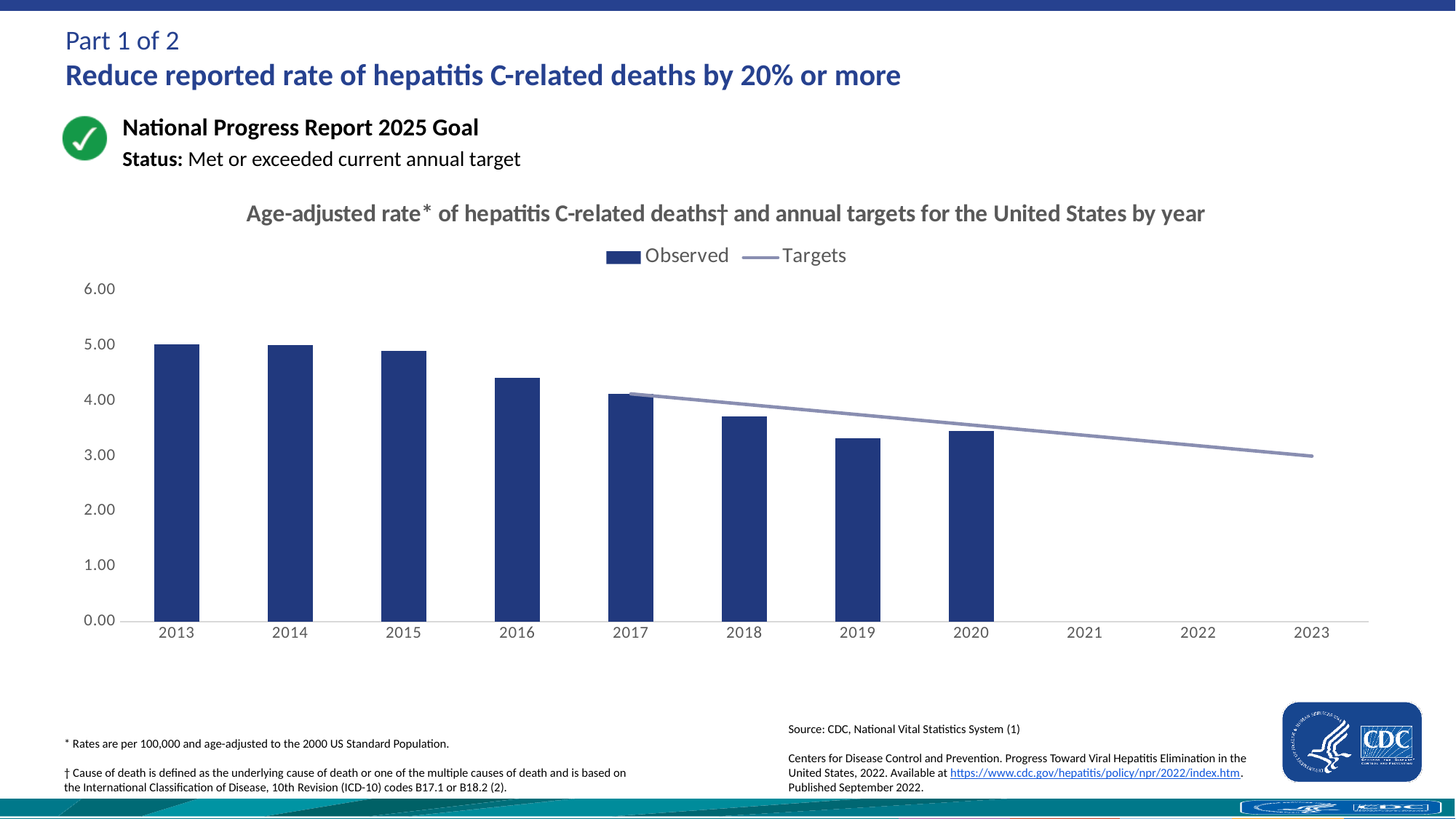
What kind of chart is shown on the slide? Bar chart with a line What is the title of the chart? Age-adjusted rate* of hepatitis C-related deaths† and annual targets for the United States by year Is the Observed value for 2013 greater or less than 4.00? greater Which year has the larger Observed value, 2016 or 2018? 2016 How many year labels appear on the x axis? 11 Do the Observed values generally rise or fall from 2013 to 2020? fall How many series does the chart legend list? 2 How many years have an Observed bar plotted? 8 Is the Observed value for 2018 greater or less than 4.00? less Is the Observed value for 2016 greater or less than 4.00? greater What are the two series named in the legend? Observed and Targets